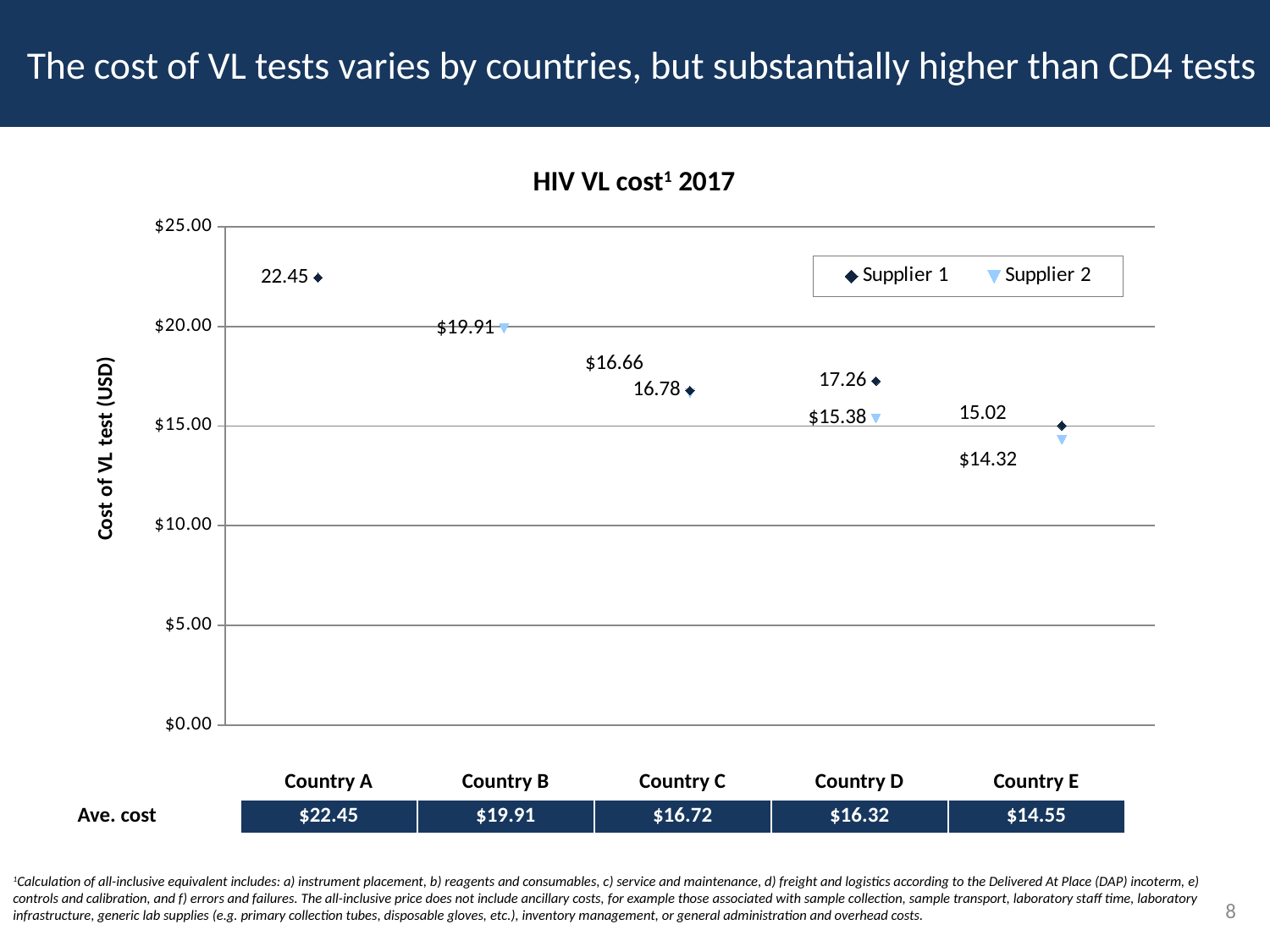
What is the Supplier 1 cost for Country A? 22.45 Which country has the lowest Supplier 2 cost? Country E What is the Supplier 2 cost for Country D? $15.38 Which country has the highest Supplier 1 cost? Country A Is the Supplier 1 value for Country A greater or less than $20.00? greater What is the Supplier 2 cost for Country B? $19.91 How many countries are shown on the x axis? 5 How many series does the legend list? 2 What is the average cost shown for Country C in the Ave. cost row? $16.72 Does the average cost rise or fall from Country A to Country E? fall What is the difference between the Supplier 1 and Supplier 2 costs for Country D? 1.88 For Country E, which supplier has the higher cost, Supplier 1 or Supplier 2? Supplier 1